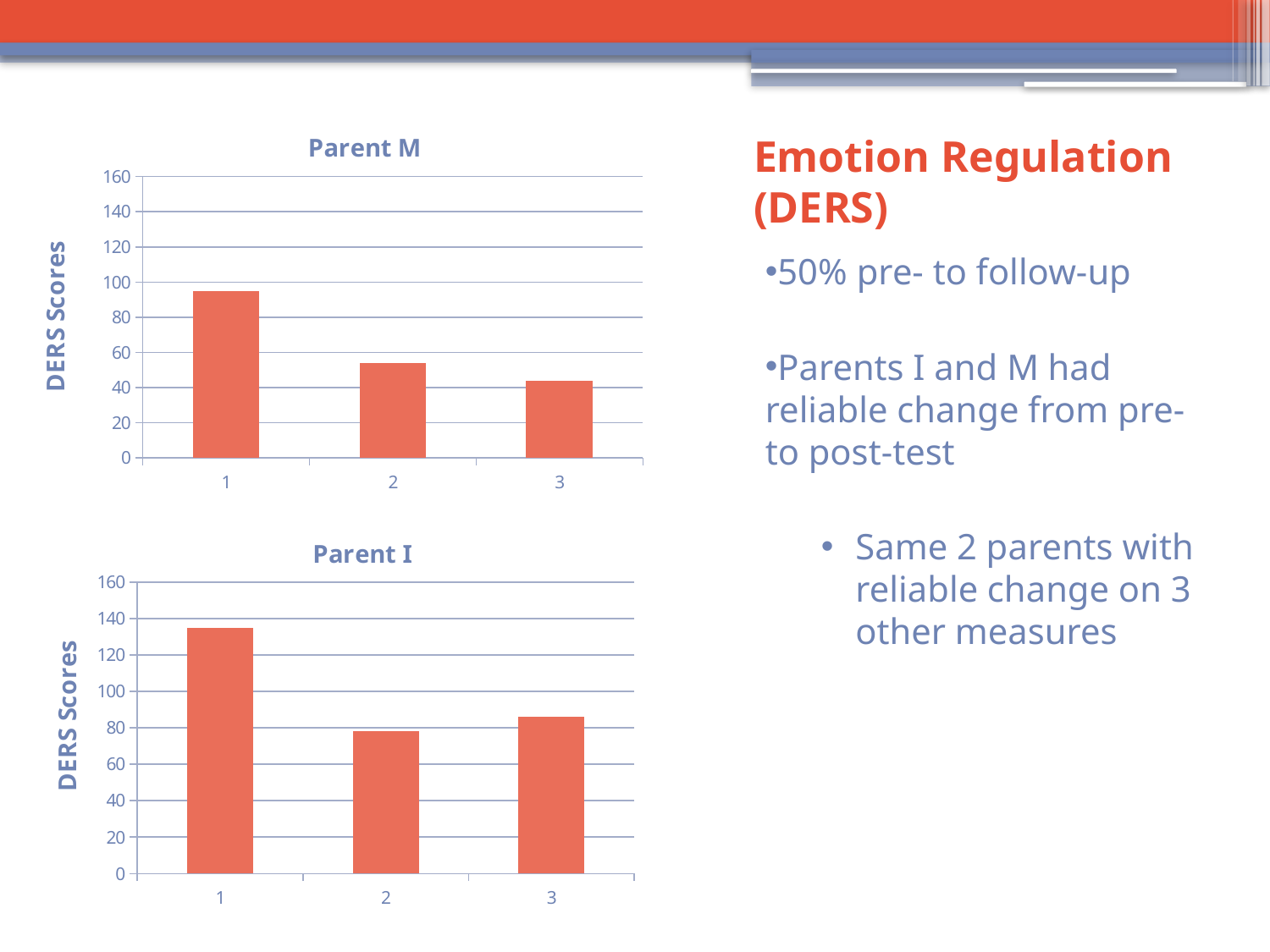
In the Parent I chart, which category has the lowest DERS score? 2 What is the y-axis label on the Parent I chart? DERS Scores In the Parent M chart, is the value for category 1 greater or less than 80? greater In the Parent I chart, is the value for category 3 greater or less than 100? less In the Parent M chart, is the value for category 2 greater or less than 60? less In the Parent M chart, which category has the lowest DERS score? 3 How many bars are plotted in the Parent I chart? 3 In the Parent I chart, which category has the highest DERS score? 1 What kind of chart is the Parent M chart? bar chart In the Parent M chart, which category has the highest DERS score? 1 In the Parent M chart, do the DERS scores rise or fall from category 1 to category 3? fall